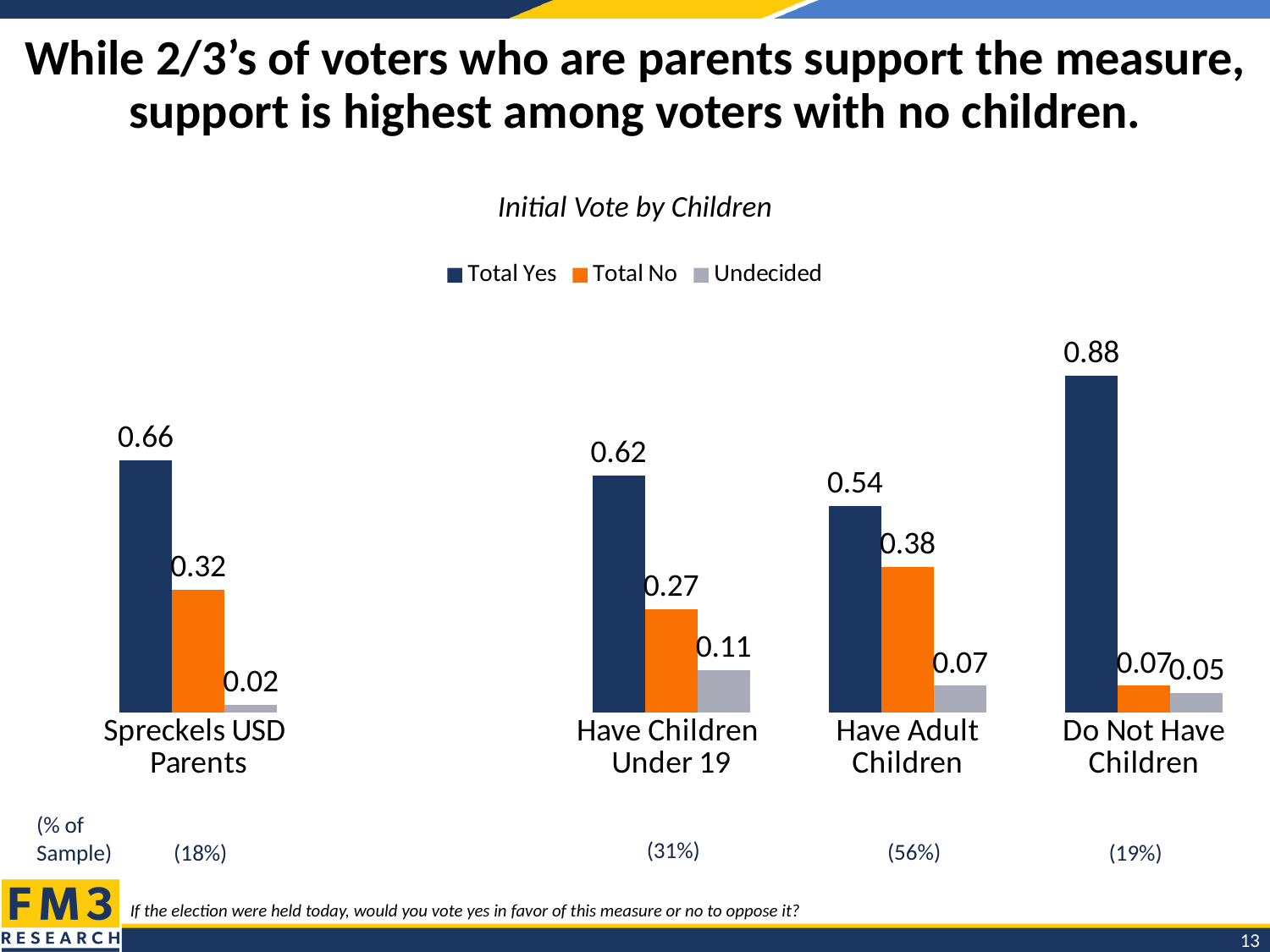
Which category has the lowest Total Yes value? Have Adult Children What is the title of the chart? Initial Vote by Children What is the Total Yes value for Have Children Under 19? 0.62 How many series does the legend list? 3 What is the Total Yes value for Do Not Have Children? 0.88 What is the Total No value for Have Adult Children? 0.38 What is the difference between the Total Yes values for Do Not Have Children and Spreckels USD Parents? 0.22 Which category has the highest Total Yes value? Do Not Have Children Which is larger, the Total No value for Spreckels USD Parents or for Have Children Under 19? Spreckels USD Parents How many categories are shown on the x axis? 4 What kind of chart is shown? Bar chart What is the Undecided value for Spreckels USD Parents? 0.02